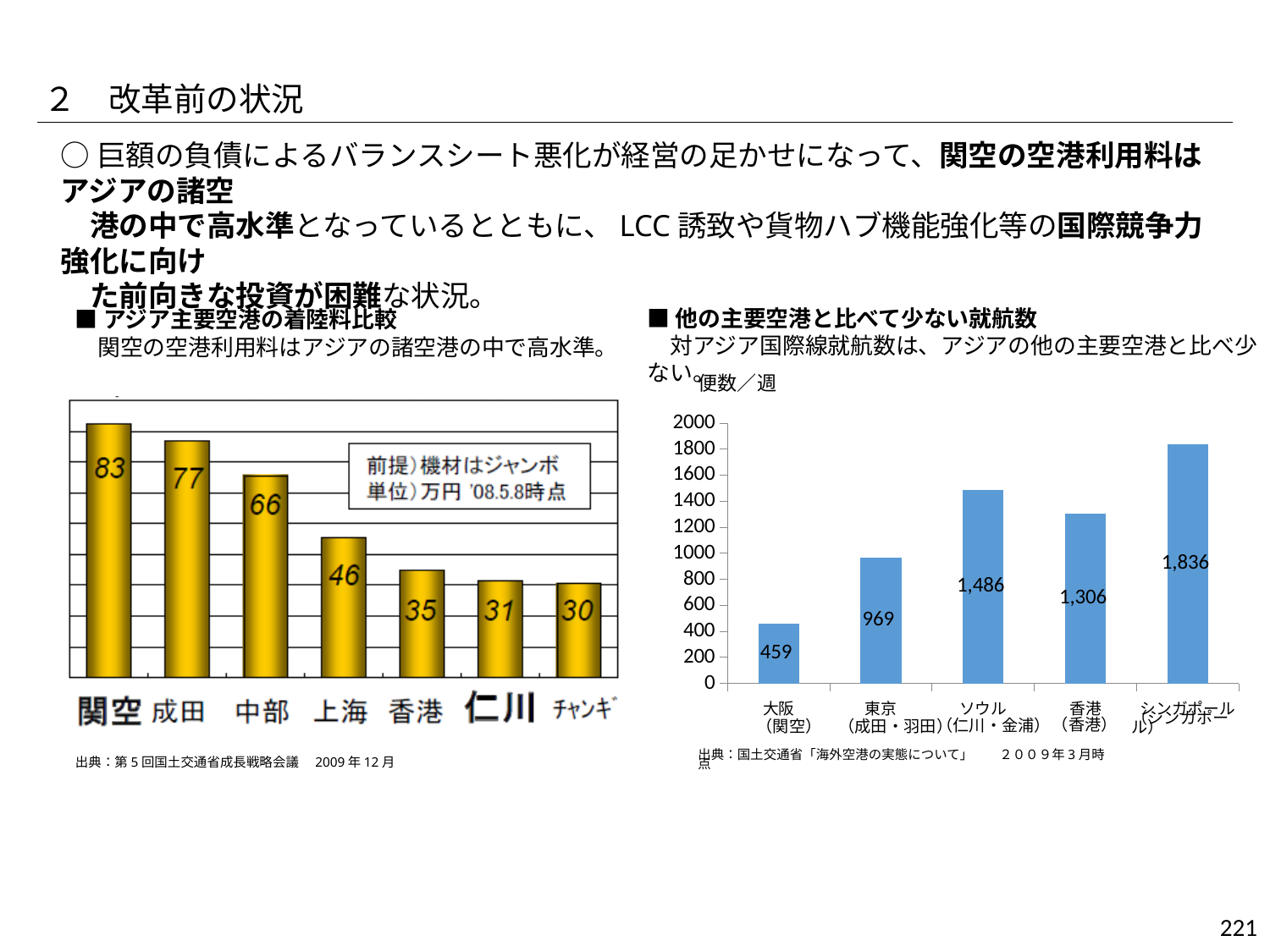
In the right chart (他の主要空港と比べて少ない就航数), which airport has the highest number of flights per week? シンガポール In the right chart (他の主要空港と比べて少ない就航数), what is the value for ソウル（仁川・金浦）? 1,486 In the right chart (他の主要空港と比べて少ない就航数), which airport has the lowest number of flights per week? 大阪（関空） In the left chart (アジア主要空港の着陸料比較), do the values rise or fall from left to right? Fall In the right chart (他の主要空港と比べて少ない就航数), what is the difference between シンガポール and 大阪（関空）? 1,377 In the left chart (アジア主要空港の着陸料比較), what is the value for 関空? 83 In the right chart (他の主要空港と比べて少ない就航数), which is larger, ソウル（仁川・金浦） or 香港（香港）? ソウル（仁川・金浦） In the right chart (他の主要空港と比べて少ない就航数), what is the value for 大阪（関空）? 459 In the left chart (アジア主要空港の着陸料比較), which airport has the lowest landing fee? チャンギ In the left chart (アジア主要空港の着陸料比較), what is the difference between 関空 and 成田? 6 In the right chart (他の主要空港と比べて少ない就航数), how many airports are plotted? 5 What kind of chart is the right chart (他の主要空港と比べて少ない就航数)? Bar chart